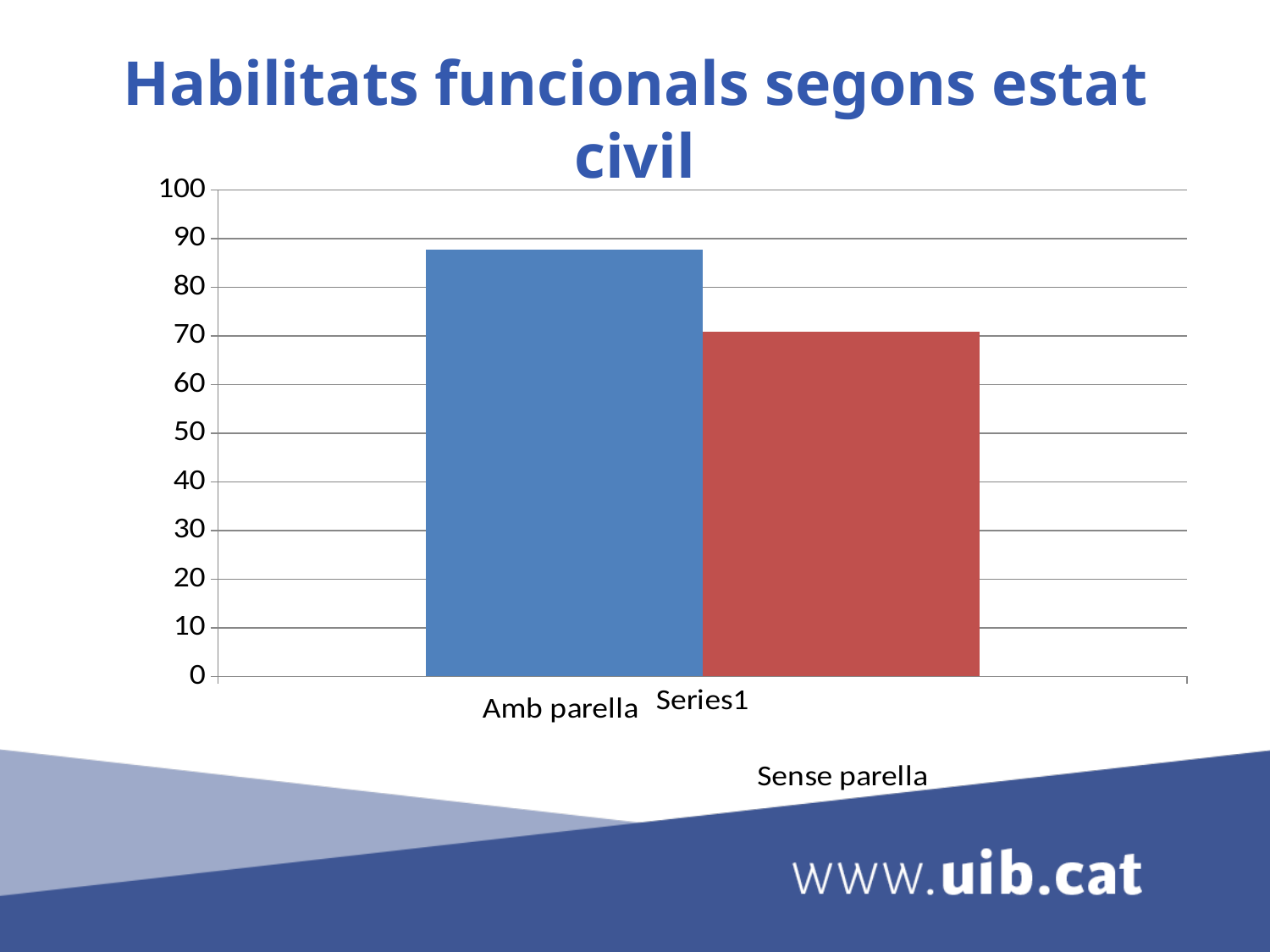
What kind of chart is shown on the slide? bar chart Is the value for Sense parella greater or less than 60? greater Which is larger, the value for Amb parella or the value for Sense parella? Amb parella How many bars are plotted in the chart? 2 Is the value for Sense parella greater or less than 80? less What is the maximum value shown on the vertical axis? 100 Which category has the lowest bar? Sense parella What colour is the bar for Amb parella? blue What is the title of the chart? Habilitats funcionals segons estat civil Which category has the highest bar? Amb parella Is the value for Amb parella greater or less than 90? less